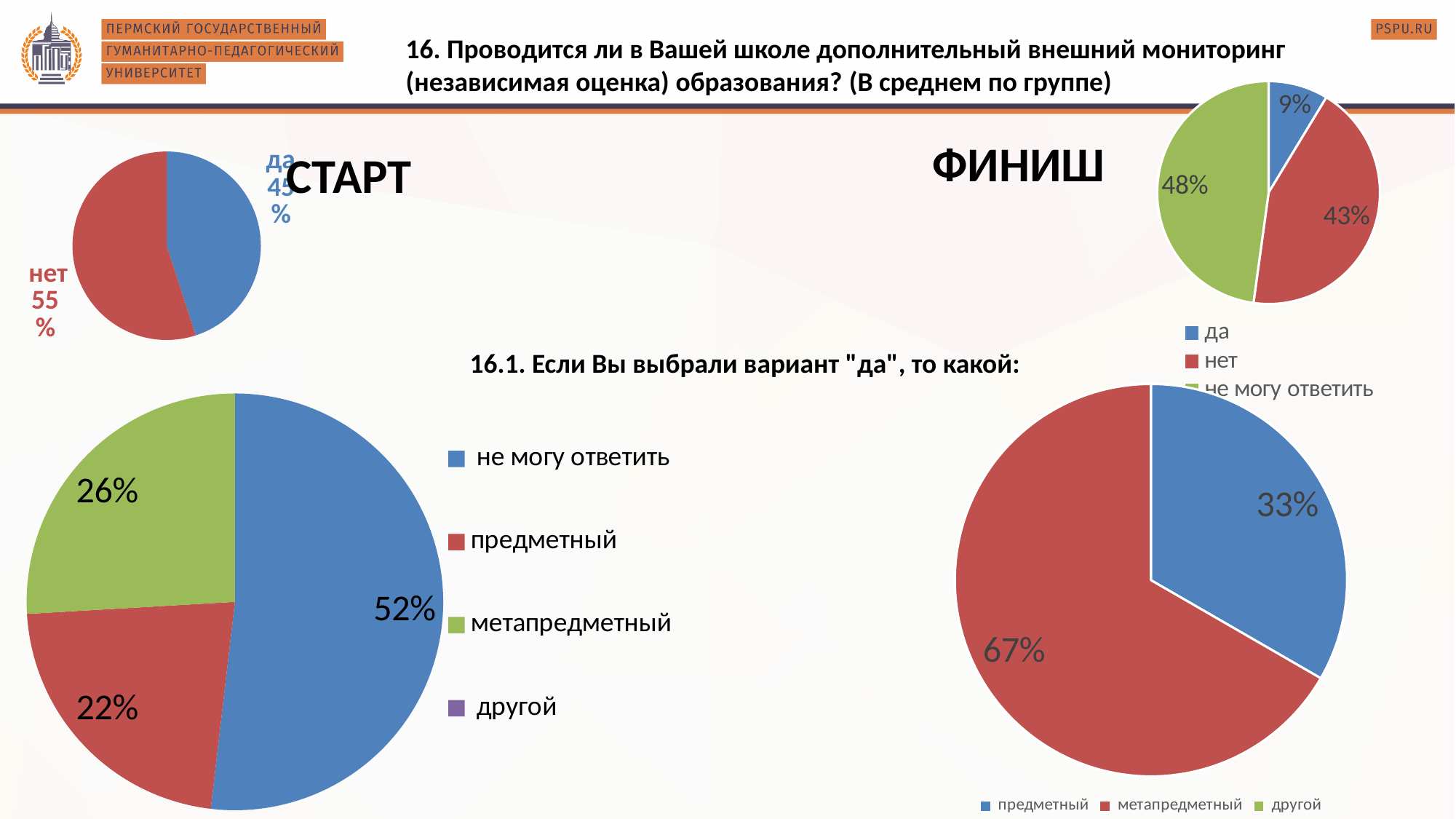
In the top-right pie chart (ФИНИШ), what is the difference between the "нет" share and the "да" share? 34% In the bottom-left pie chart, which category has the largest share? не могу ответить In the bottom-left pie chart, what is the value for "предметный"? 22% In the top-right pie chart (ФИНИШ), which category has the largest share? не могу ответить In the bottom-right pie chart, what is the value for "метапредметный"? 67% In the top-right pie chart (ФИНИШ), which category has the smallest share? да In the top-right pie chart (ФИНИШ), what is the value for "да"? 9% In the bottom-right pie chart, which is larger, "предметный" or "метапредметный"? метапредметный In the top-left pie chart (СТАРТ), what share is labelled "да"? 45% In the bottom-left pie chart, how many entries does the legend list? 4 What type of chart is the bottom-right chart? pie chart In the top-left pie chart (СТАРТ), what share is labelled "нет"? 55%